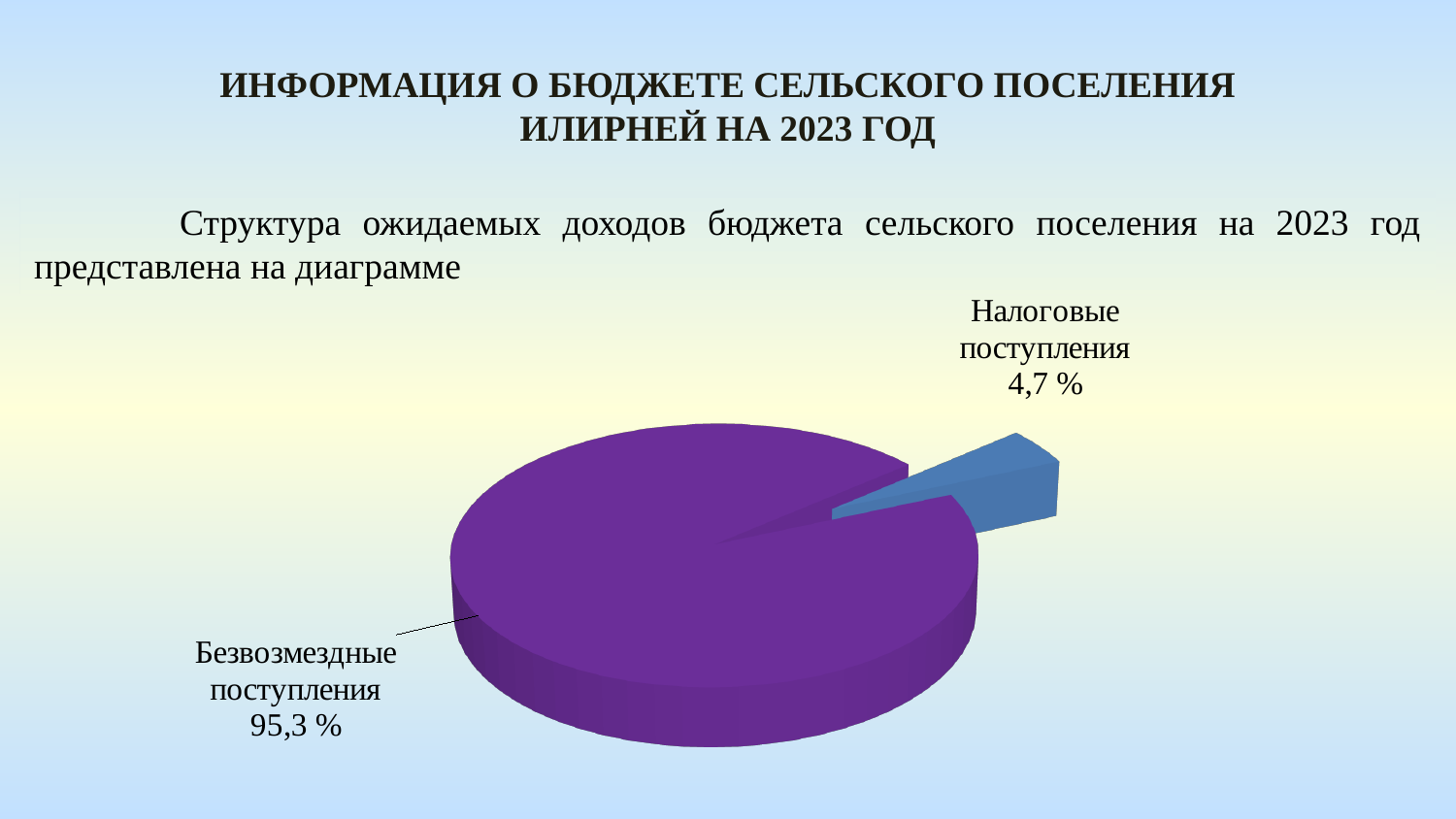
Which category has the largest slice of the pie? Безвозмездные поступления What share of the pie does Налоговые поступления represent? 4,7 % What colour is the slice for Налоговые поступления? Blue What colour is the slice for Безвозмездные поступления? Purple How many slices does the pie chart have? 2 What kind of chart is shown on the slide? Pie chart Which category has the smallest slice of the pie? Налоговые поступления What is the difference in percentage points between Безвозмездные поступления and Налоговые поступления? 90,6 Which is larger, Налоговые поступления or Безвозмездные поступления? Безвозмездные поступления What share of the pie does Безвозмездные поступления represent? 95,3 %